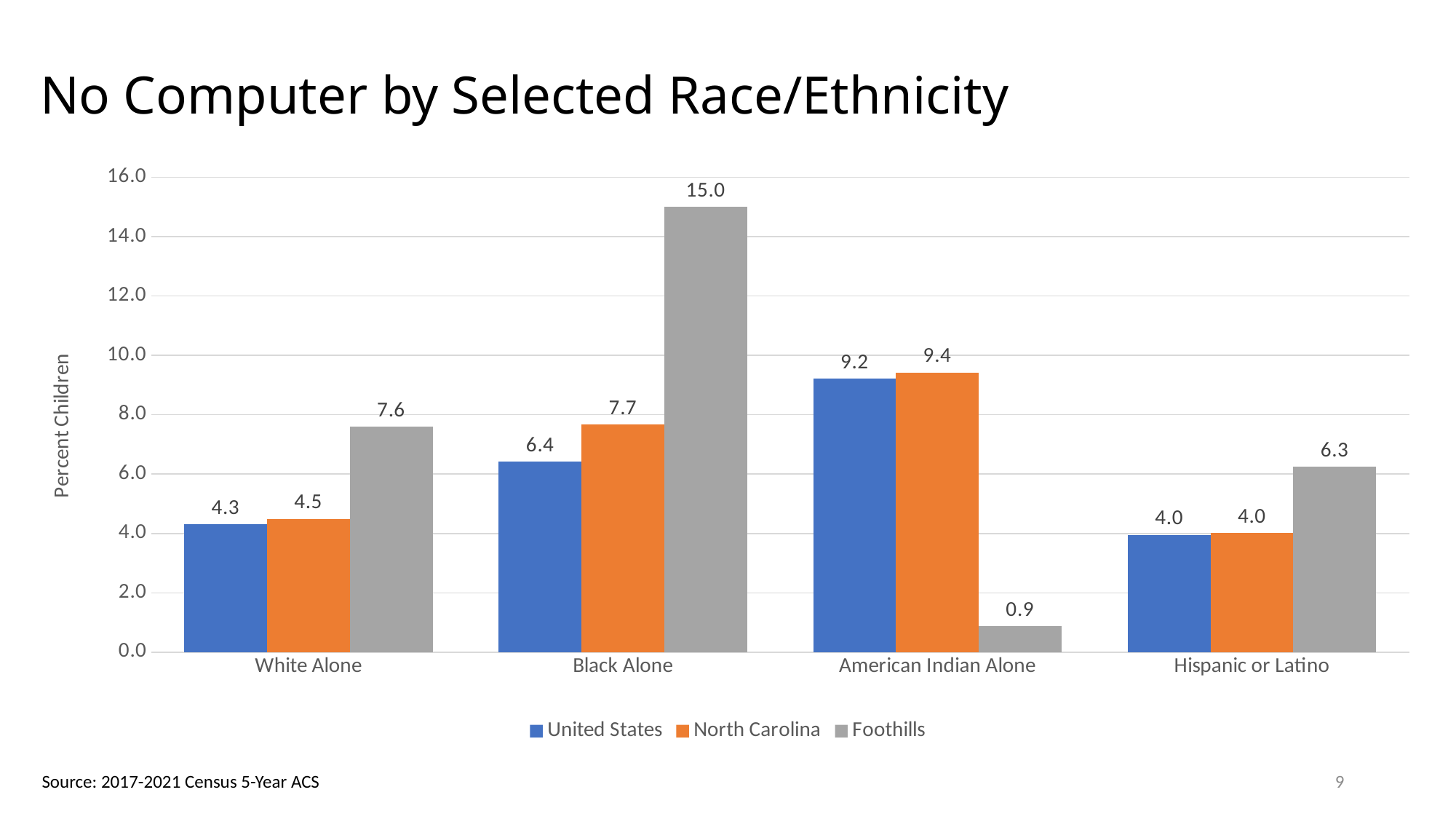
What is the North Carolina value for White Alone? 4.5 Is the Foothills value for White Alone greater or less than 8.0? less What kind of chart is shown on the slide? bar chart What is the Foothills value for Black Alone? 15.0 Which category has the highest Foothills value? Black Alone How many series does the legend list? 3 What is the label of the y axis? Percent Children Which is larger for Hispanic or Latino: the Foothills value or the United States value? Foothills Which category has the lowest Foothills value? American Indian Alone What is the difference between the Foothills and North Carolina values for Black Alone? 7.3 How many race/ethnicity categories are shown on the x axis? 4 What is the United States value for American Indian Alone? 9.2